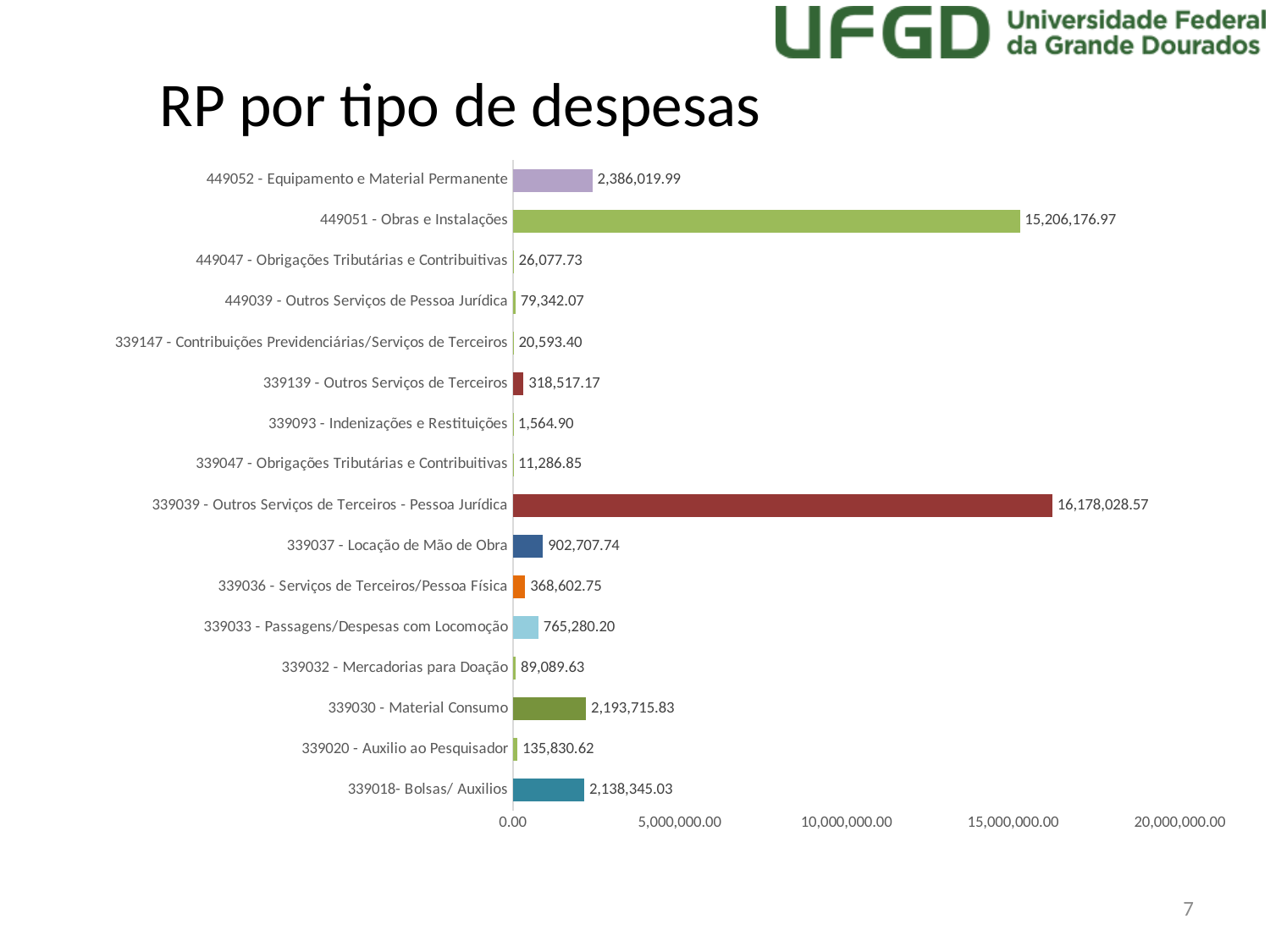
What is the value for 339093 - Indenizações e Restituições? 1,564.90 What is the difference between the values for 449052 - Equipamento e Material Permanente and 339030 - Material Consumo? 192,304.16 Which is larger, the value for 339037 - Locação de Mão de Obra or the value for 339033 - Passagens/Despesas com Locomoção? 339037 - Locação de Mão de Obra Which category has the highest value? 339039 - Outros Serviços de Terceiros - Pessoa Jurídica What is the value for 339037 - Locação de Mão de Obra? 902,707.74 Is the value for 449051 - Obras e Instalações greater or less than 15,000,000.00? greater How many categories are shown in the chart? 16 What is the difference between the values for 339039 - Outros Serviços de Terceiros - Pessoa Jurídica and 449051 - Obras e Instalações? 971,851.60 What is the value for 339018- Bolsas/ Auxilios? 2,138,345.03 Which category has the lowest value? 339093 - Indenizações e Restituições What is the value for 449051 - Obras e Instalações? 15,206,176.97 What kind of chart is shown on the slide? bar chart